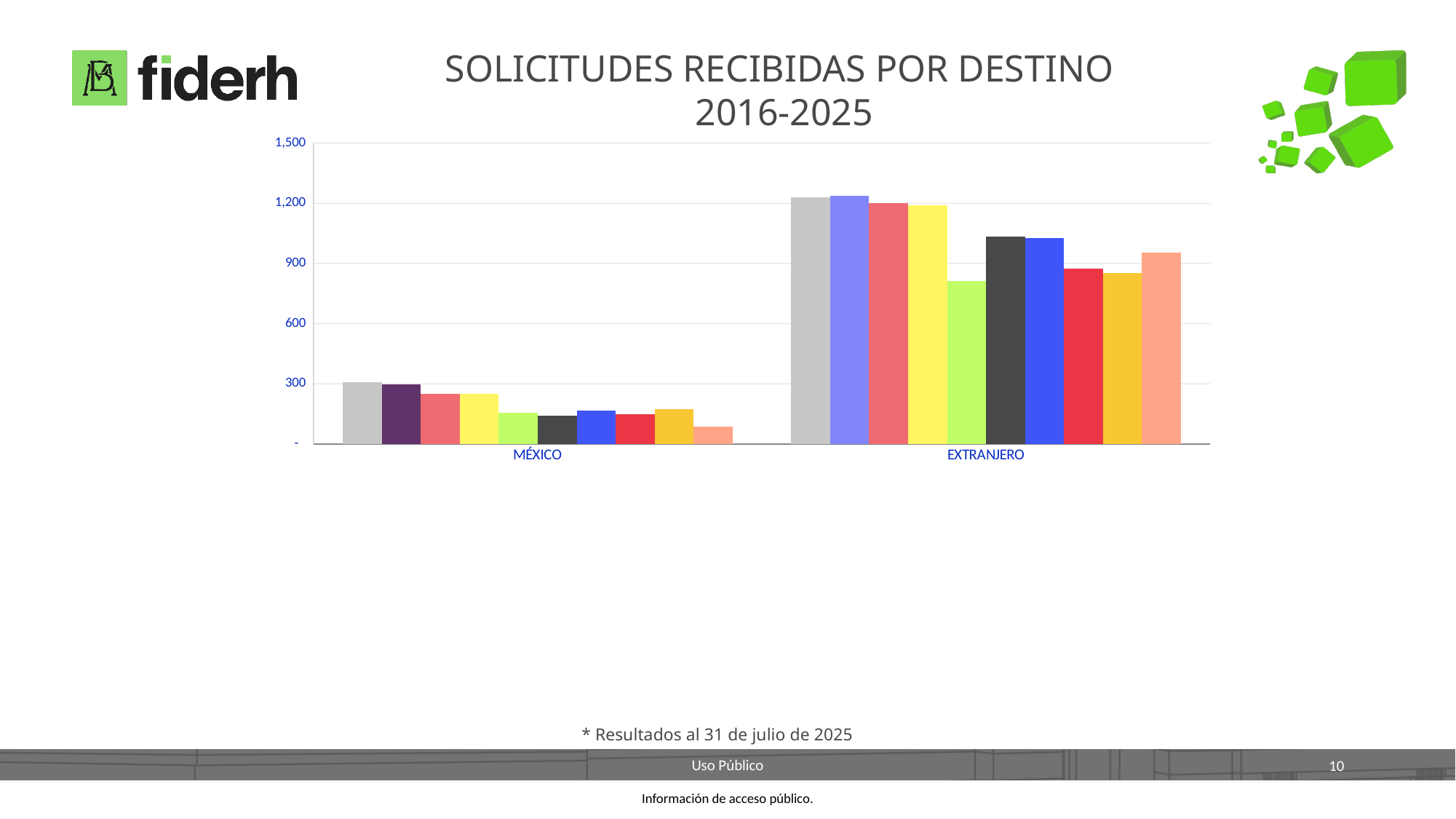
How many bars are plotted for the MÉXICO category? 10 Is the tallest bar for MÉXICO greater or less than 600? less Is the light green bar for EXTRANJERO greater or less than 900? less What are the two categories on the x axis? MÉXICO and EXTRANJERO Is the rightmost bar for MÉXICO greater or less than 300? less What is the title of the chart? SOLICITUDES RECIBIDAS POR DESTINO 2016-2025 Which category has the shortest bar, MÉXICO or EXTRANJERO? MÉXICO Is the tallest bar for MÉXICO larger or smaller than the shortest bar for EXTRANJERO? smaller Which category has the tallest bar, MÉXICO or EXTRANJERO? EXTRANJERO How many categories are shown on the x axis? 2 What kind of chart is shown on the slide? bar chart